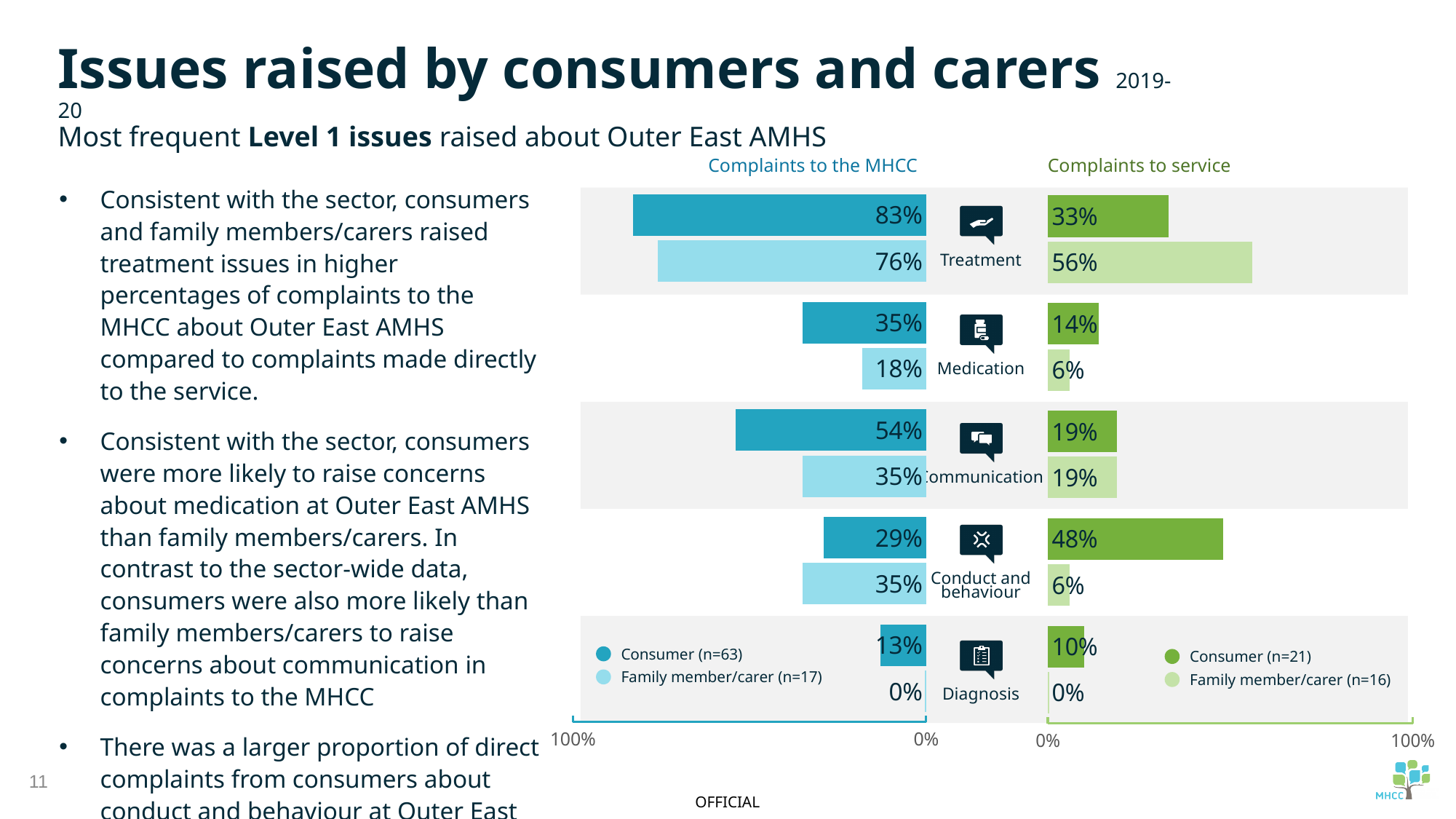
In the 'Complaints to service' chart, which issue has the lowest family member/carer percentage? Diagnosis In the 'Complaints to the MHCC' chart, what is the difference between the consumer and family member/carer percentages for communication? 19% How many issue categories are shown in the 'Complaints to the MHCC' chart? 5 What type of chart is the 'Complaints to the MHCC' chart? Bar chart According to the legend of the 'Complaints to the MHCC' chart, how many consumers are in the sample? n=63 In the 'Complaints to service' chart, which is larger for treatment: the consumer value or the family member/carer value? Family member/carer In the 'Complaints to the MHCC' chart, which issue has the highest consumer percentage? Treatment In the 'Complaints to the MHCC' chart, what is the family member/carer value for medication? 18% In the 'Complaints to service' chart, what percentage of family member/carer complaints raised treatment issues? 56% How many series does the legend of the 'Complaints to service' chart list? 2 In the 'Complaints to service' chart, what is the consumer value for conduct and behaviour? 48% In the 'Complaints to the MHCC' chart, what percentage of consumer complaints raised treatment issues? 83%